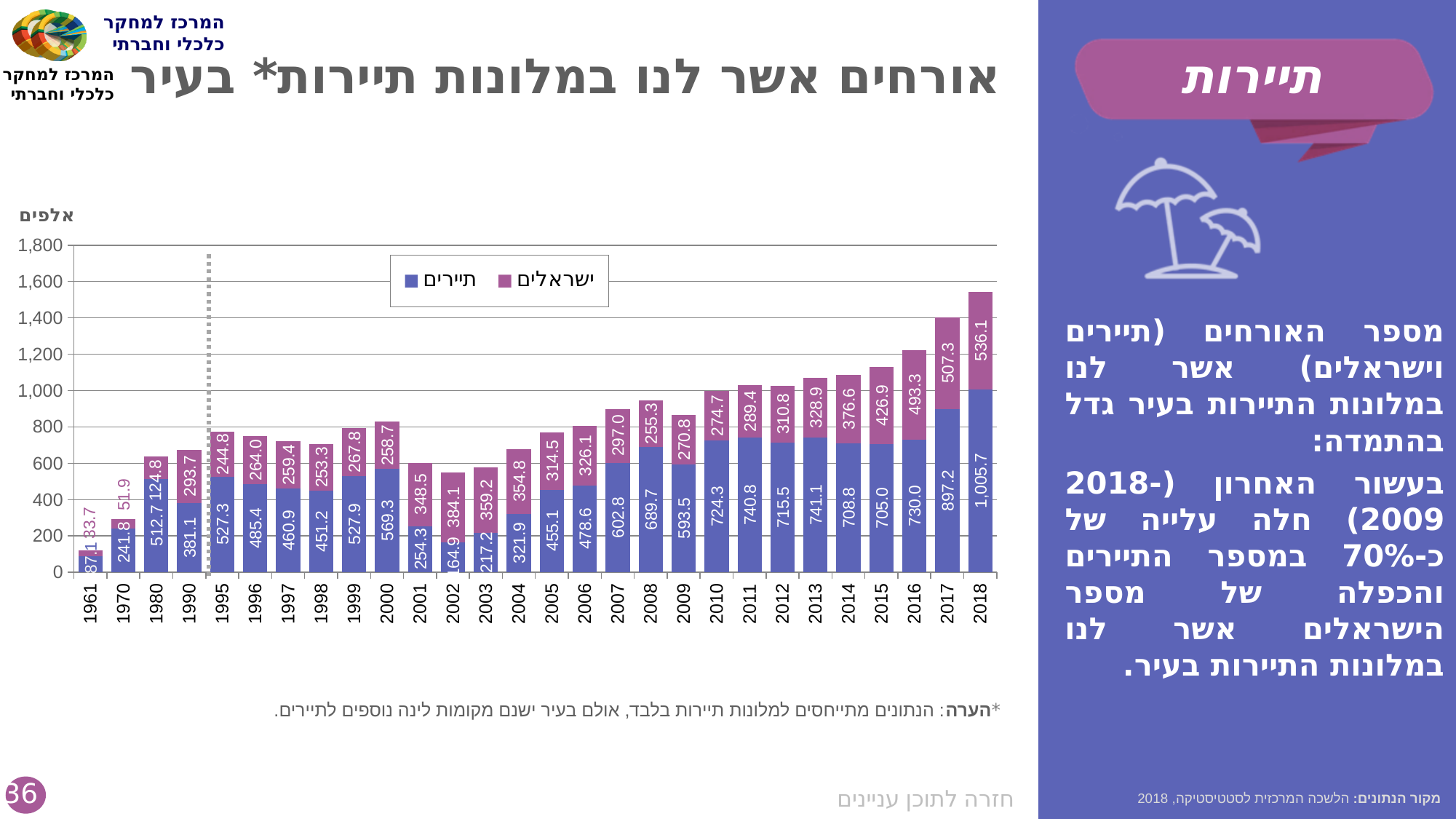
In which year is the ישראלים (Israelis) value lowest? 1961 How many years are shown on the x axis? 28 What type of chart is shown on the slide? stacked bar chart In which year is the תיירים (tourists) value highest? 2018 What is the difference between the תיירים (tourists) values for 2018 and 2017? 108.5 What is the value for ישראלים (Israelis) in 2002? 384.1 Do the ישראלים (Israelis) values rise or fall from 2008 to 2018? rise How many series does the legend list? 2 What is the value for תיירים (tourists) in 2018? 1,005.7 In 2002, which is larger: the תיירים (tourists) value or the ישראלים (Israelis) value? ישראלים (Israelis) What is the value for תיירים (tourists) in 2008? 689.7 What is the total of the stacked bar for 2017? 1,404.5